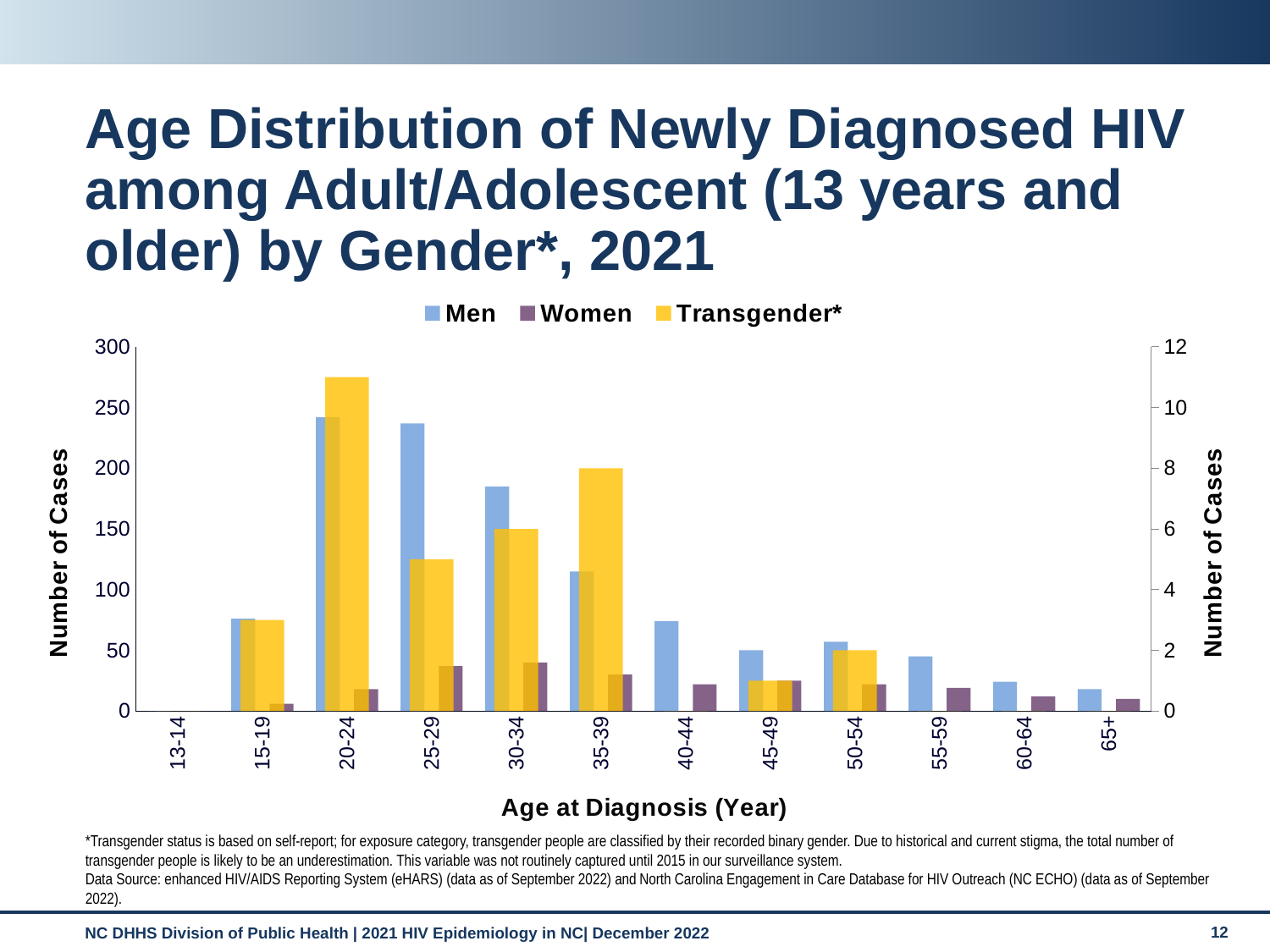
Is the value for Men in the 35-39 age group greater or less than 150? less How many age groups are shown on the x axis? 12 Do the values for Men rise or fall from the 25-29 age group to the 45-49 age group? fall How many series does the legend list? 3 Is the value for Men in the 40-44 age group greater or less than 100? less Which is larger for Women: the 30-34 age group or the 15-19 age group? 30-34 What is the title of the x axis? Age at Diagnosis (Year) What kind of chart is shown on the slide? bar chart Which is larger for Men: the 20-24 age group or the 35-39 age group? 20-24 Is the value for Men in the 20-24 age group greater or less than 200? greater Which age group has the highest value for Transgender*? 20-24